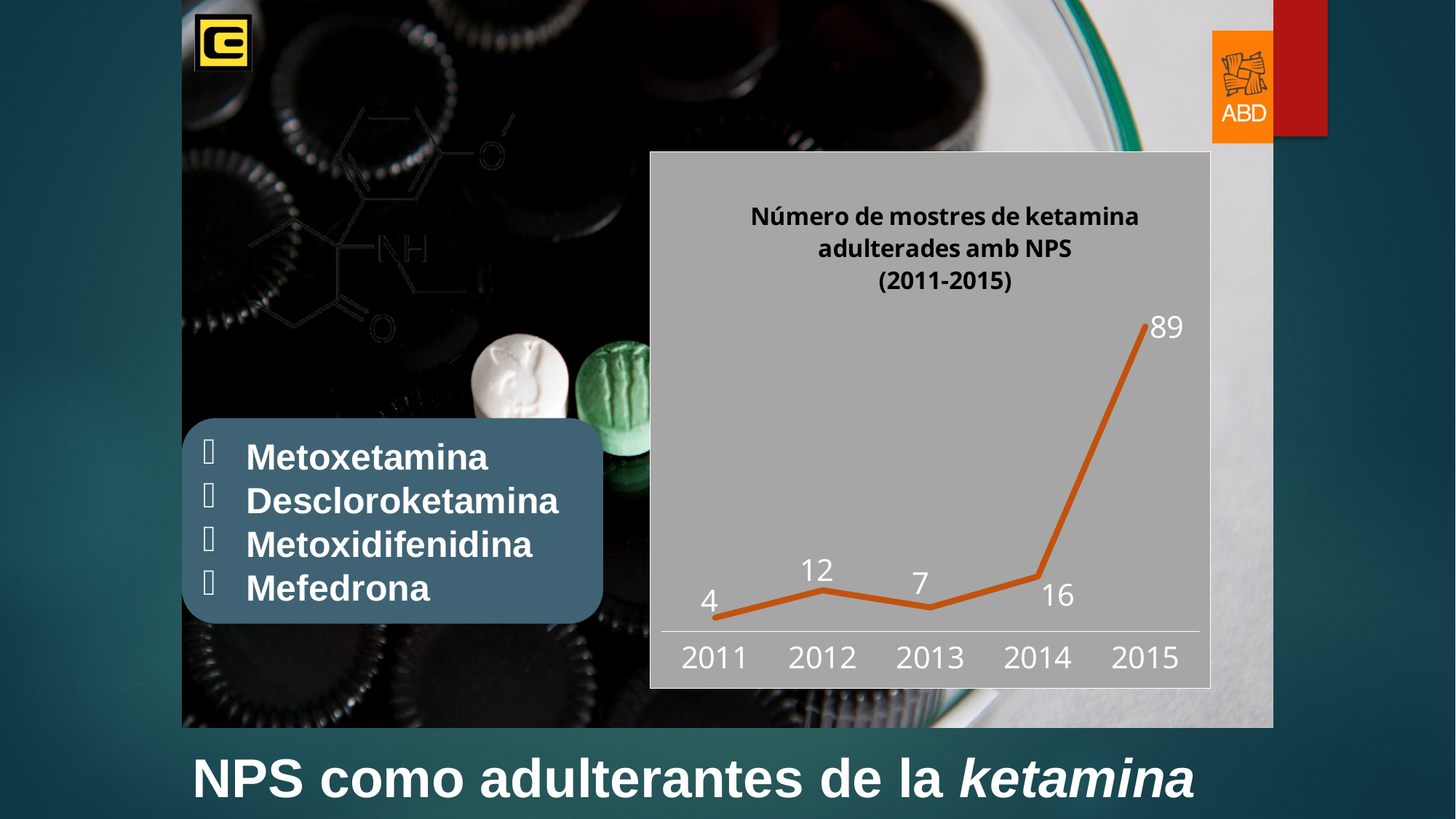
What is the value for 2013? 7 What is the value for 2011? 4 Which is larger, the value for 2012 or the value for 2014? 2014 How many years are plotted on the chart? 5 What kind of chart is shown? line chart Which year has the highest value? 2015 What is the value for 2014? 16 What is the difference between the values for 2012 and 2013? 5 Which year has the lowest value? 2011 What is the value for 2015? 89 What is the difference between the values for 2015 and 2014? 73 What is the title of the chart? Número de mostres de ketamina adulterades amb NPS (2011-2015)